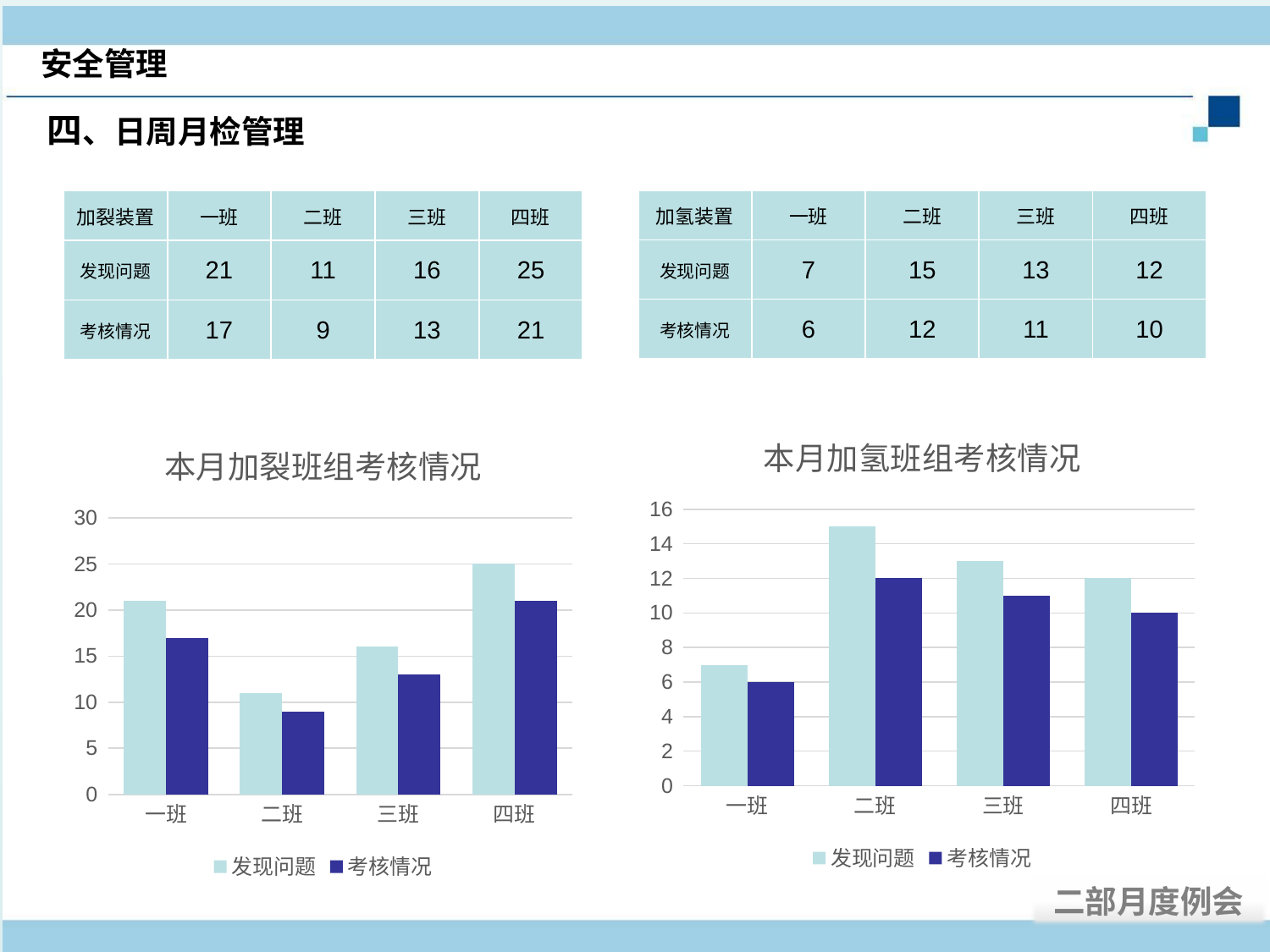
How many series does the legend of the chart titled 本月加裂班组考核情况 list? 2 In the chart titled 本月加裂班组考核情况, is the 考核情况 value for 一班 greater or less than 15? greater In the chart titled 本月加氢班组考核情况, is the 发现问题 value for 一班 greater or less than 8? less In the chart titled 本月加氢班组考核情况, what is the difference between the 发现问题 and 考核情况 values for 二班? 3 What kind of chart is the chart titled 本月加裂班组考核情况? bar chart In the chart titled 本月加氢班组考核情况, what is the 考核情况 value for 一班? 6 In the chart titled 本月加裂班组考核情况, what is the 发现问题 value for 四班? 25 In the chart titled 本月加裂班组考核情况, which 班 has the lowest 考核情况 value? 二班 In the chart titled 本月加氢班组考核情况, which has the larger 发现问题 value, 二班 or 三班? 二班 How many 班 categories are shown on the x axis of the chart titled 本月加裂班组考核情况? 4 In the chart titled 本月加裂班组考核情况, which 班 has the highest 发现问题 value? 四班 In the chart titled 本月加氢班组考核情况, which 班 has the highest 发现问题 value? 二班